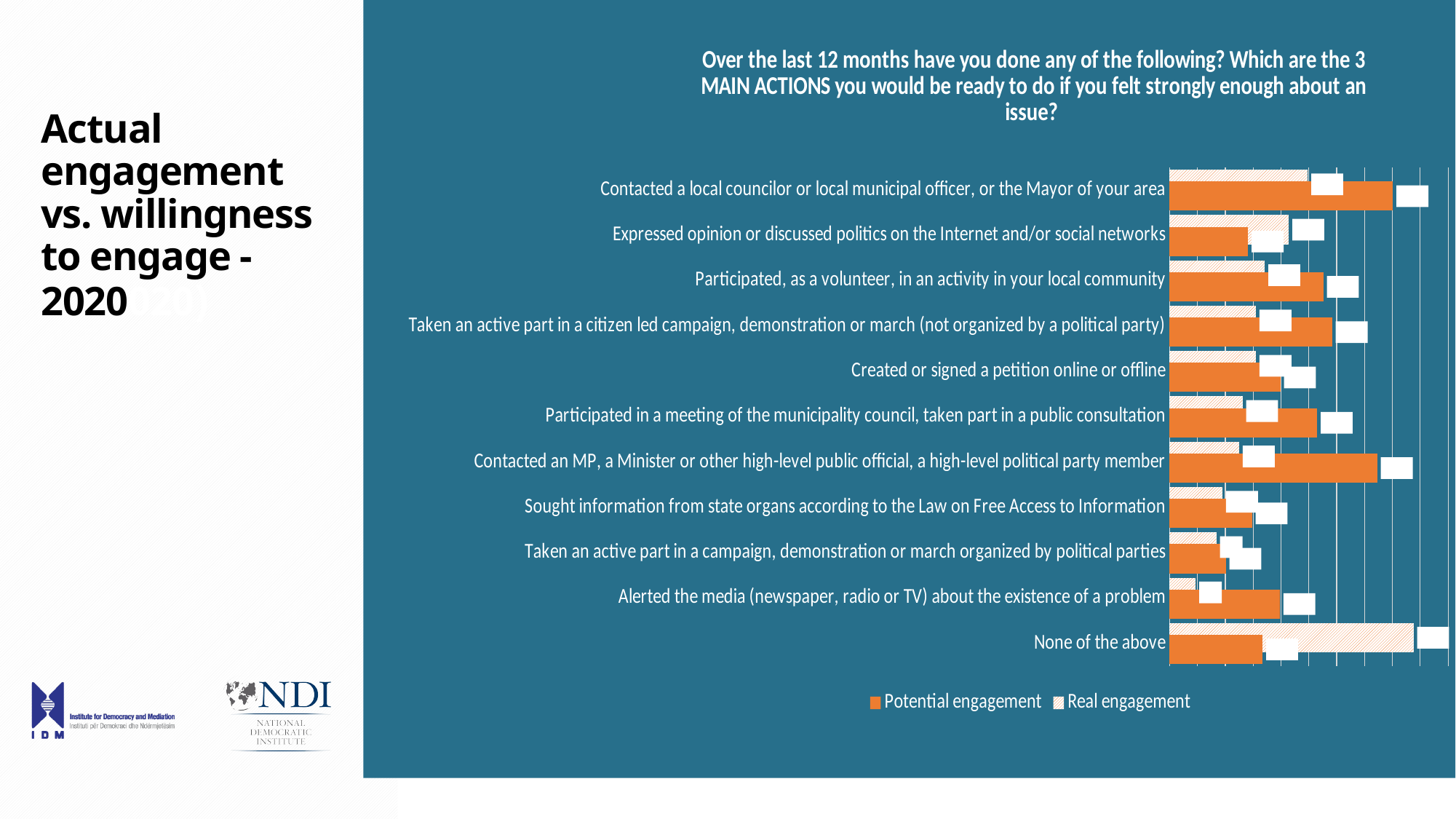
For 'Contacted a local councilor or local municipal officer, or the Mayor of your area', which is larger: Potential engagement or Real engagement? Potential engagement Which category has the lowest Real engagement value? Alerted the media (newspaper, radio or TV) about the existence of a problem Which category has the lowest Potential engagement value? Taken an active part in a campaign, demonstration or march organized by political parties For 'None of the above', which is larger: Potential engagement or Real engagement? Real engagement For 'Alerted the media (newspaper, radio or TV) about the existence of a problem', which is larger: Potential engagement or Real engagement? Potential engagement What kind of chart is shown on the slide? Bar chart How many series does the chart legend list? 2 What are the two series named in the legend? Potential engagement and Real engagement Which category has the highest Real engagement value? None of the above Which series is shown with solid orange bars? Potential engagement How many categories (actions) are listed on the chart? 11